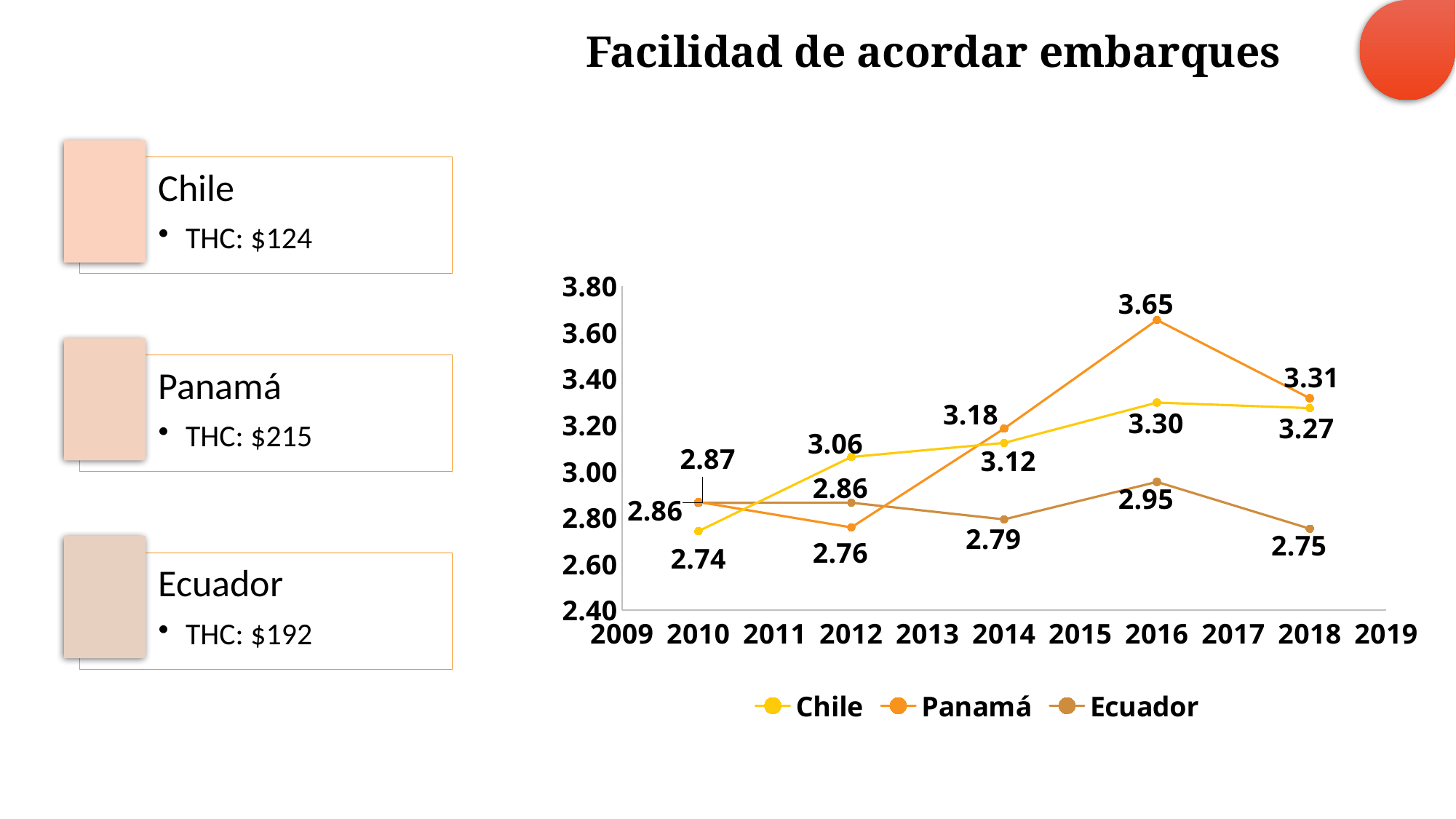
How many series does the chart legend list? 3 In which year does Panamá reach its highest value? 2016 What is the value for Ecuador in 2018? 2.75 In 2014, which series has the larger value, Chile or Panamá? Panamá What is the title of the chart? Facilidad de acordar embarques Does the Chile line rise or fall from 2010 to 2016? rise How many data points are plotted for each series? 5 What is the value for Panamá in 2016? 3.65 What is the difference between the Panamá and Chile values in 2016? 0.35 What is the value for Chile in 2012? 3.06 In which year does Chile have its lowest value? 2010 What kind of chart is shown on the slide? line chart